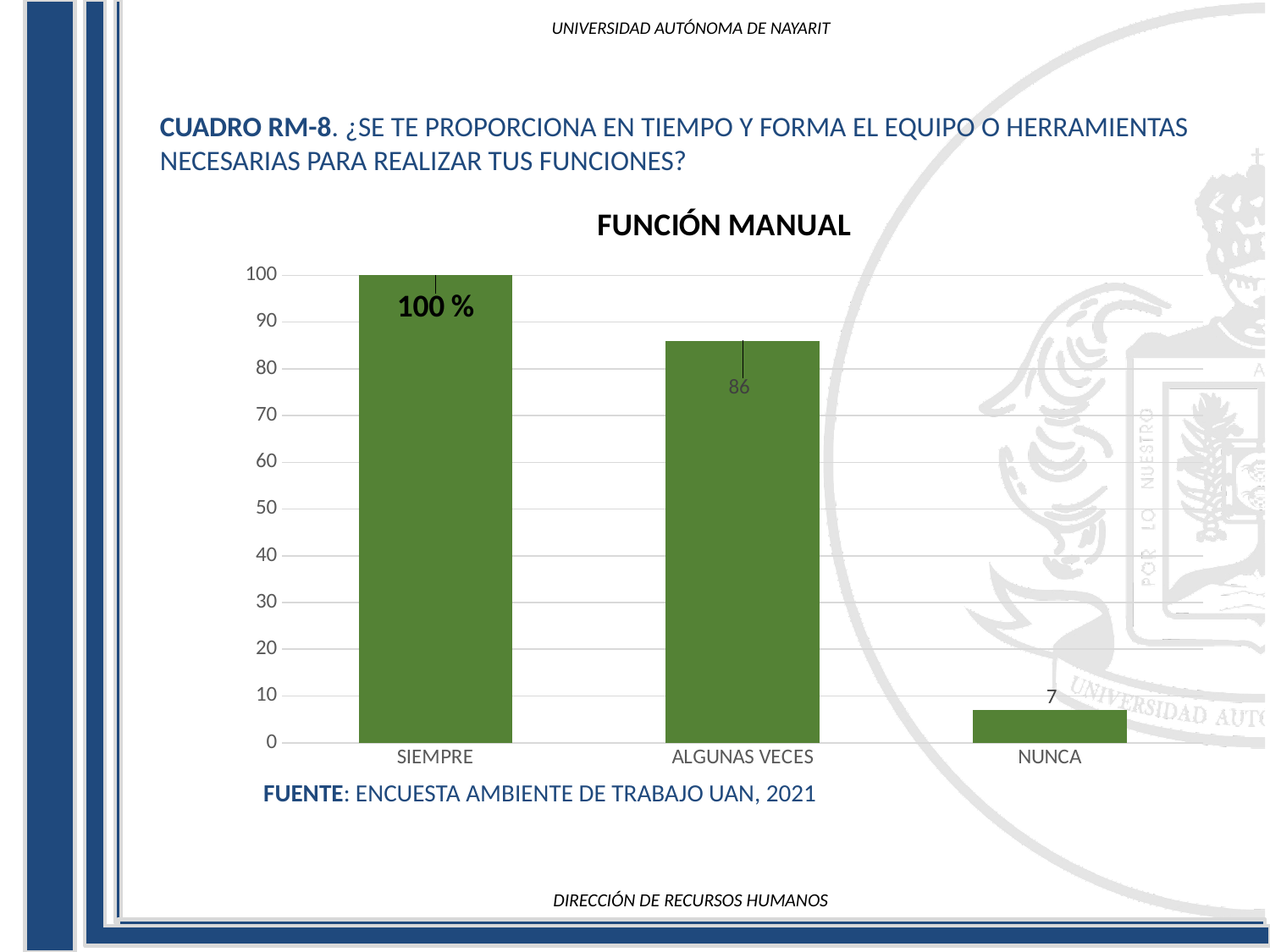
Do the values in the FUNCIÓN MANUAL chart rise or fall from SIEMPRE to NUNCA along the x axis? fall How many categories are shown in the FUNCIÓN MANUAL chart? 3 Is the value for ALGUNAS VECES in the FUNCIÓN MANUAL chart greater or less than 80? greater What is the value for ALGUNAS VECES in the FUNCIÓN MANUAL chart? 86 What value is labelled on the SIEMPRE bar in the FUNCIÓN MANUAL chart? 100 % What is the difference between the values for ALGUNAS VECES and NUNCA in the FUNCIÓN MANUAL chart? 79 Which category has the lowest value in the FUNCIÓN MANUAL chart? NUNCA What kind of chart is the FUNCIÓN MANUAL chart? bar chart What is the value for NUNCA in the FUNCIÓN MANUAL chart? 7 Is the value for NUNCA in the FUNCIÓN MANUAL chart greater or less than 10? less Which is larger in the FUNCIÓN MANUAL chart, the value for ALGUNAS VECES or the value for NUNCA? ALGUNAS VECES Which category has the highest value in the FUNCIÓN MANUAL chart? SIEMPRE